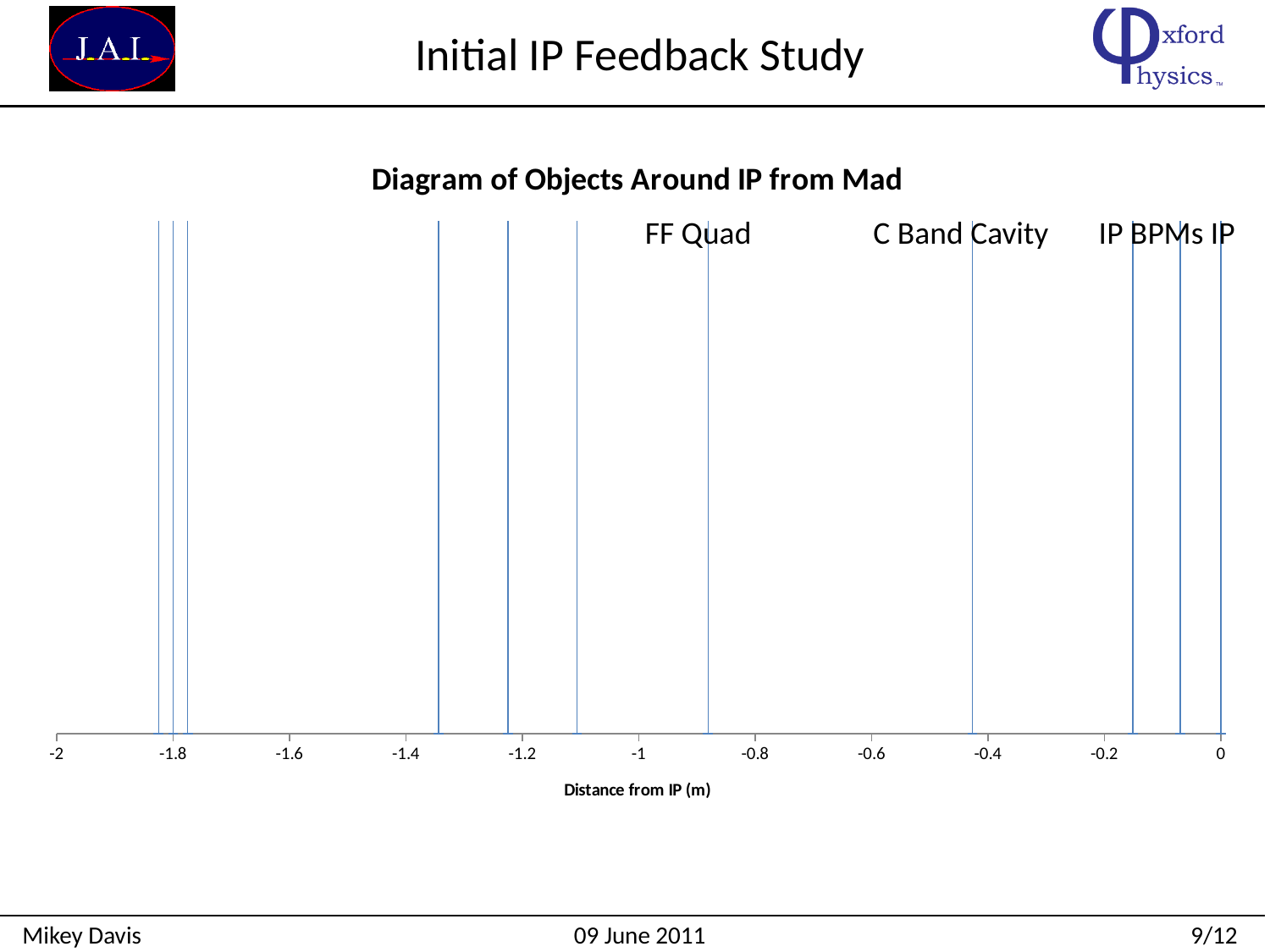
Is the position of the C Band Cavity greater or less than -0.2 on the x axis? less Is the position of the FF Quad greater or less than -1 on the x axis? greater Are the IP BPMs positioned at a value greater or less than -0.2 on the x axis? greater Which is closer to the IP, the FF Quad or the C Band Cavity? C Band Cavity What is the label of the x axis? Distance from IP (m) How many tick labels are shown on the x axis? 11 Which labelled object is furthest from the IP, the FF Quad, the C Band Cavity or the IP BPMs? FF Quad What is the title of the chart? Diagram of Objects Around IP from Mad What is the lowest value shown on the x axis? -2 What is the highest value shown on the x axis? 0